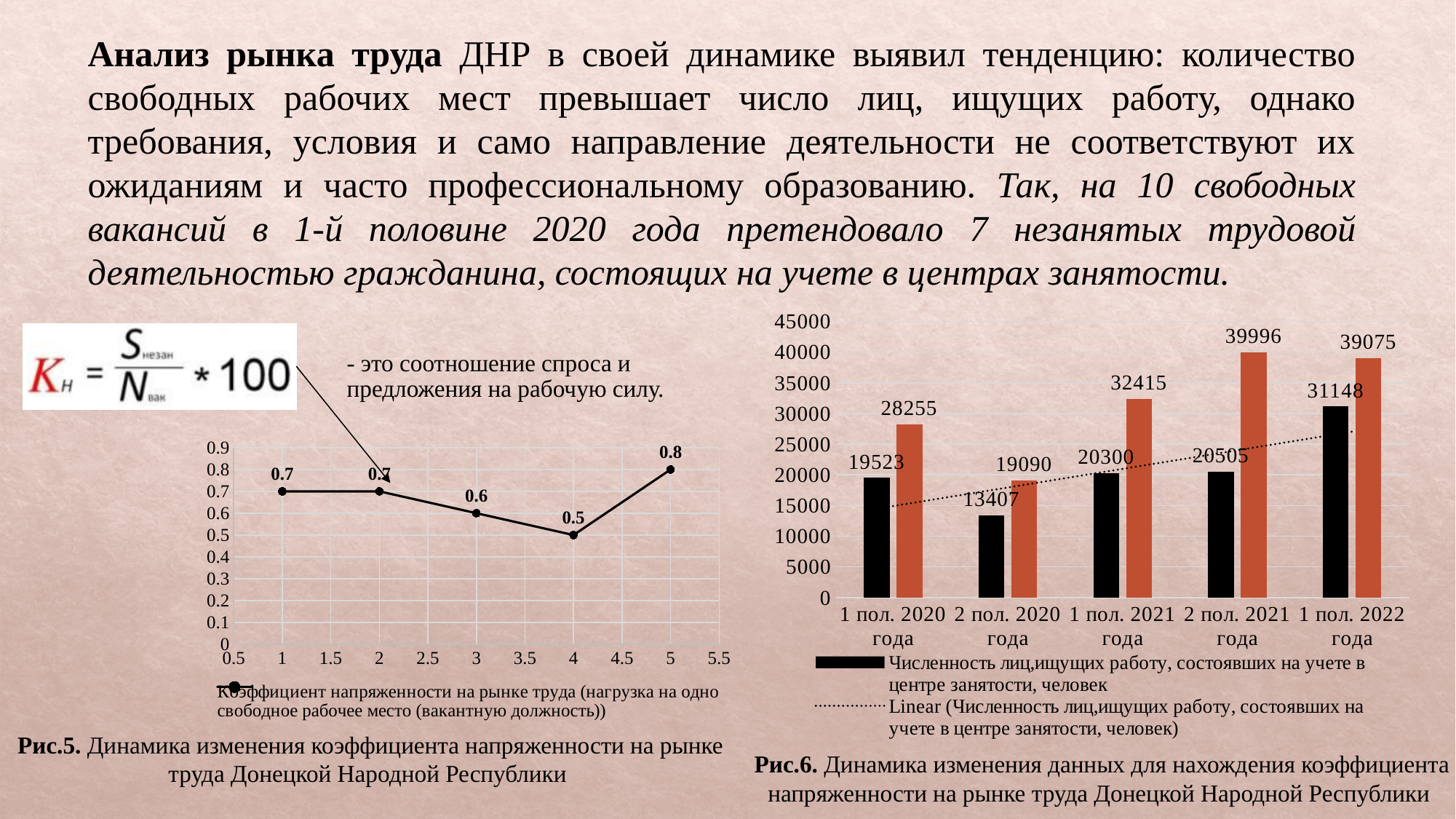
What kind of chart is the left chart (Рис.5)? line chart In the left chart (Рис.5), at which x value is the plotted value lowest? 4 In the right chart (Рис.6), is the black bar for 1 пол. 2020 года greater or less than 20000? less In the right chart (Рис.6), what is the value of the orange bar for 2 пол. 2021 года? 39996 What kind of chart is the right chart (Рис.6)? bar chart In the right chart (Рис.6), what is the difference between the orange bar and the black bar for 1 пол. 2021 года? 12115 In the left chart (Рис.5), what is the value of the point at x = 5? 0.8 In the left chart (Рис.5), what is the value of the point at x = 4? 0.5 In the right chart (Рис.6), which period has the lowest black bar? 2 пол. 2020 года In the left chart (Рис.5), how many data points are plotted? 5 In the right chart (Рис.6), which period has the highest orange bar? 2 пол. 2021 года In the right chart (Рис.6), what is the value of the black bar for 1 пол. 2022 года? 31148